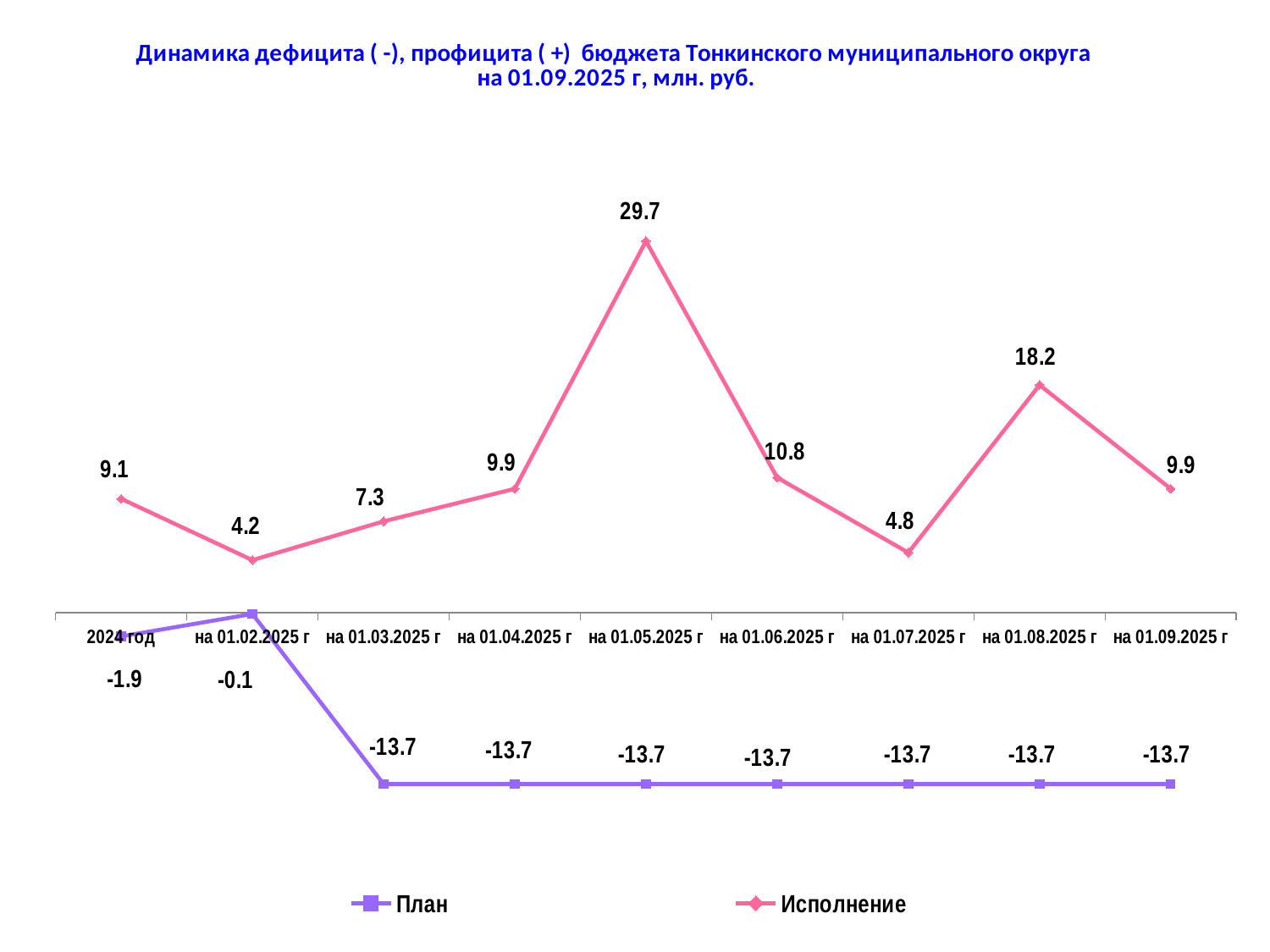
How many series does the legend list? 2 What is the value of Исполнение for на 01.05.2025 г? 29.7 Which series is drawn in pink? Исполнение What is the value of План for на 01.09.2025 г? -13.7 Which is larger: Исполнение for на 01.03.2025 г or for на 01.07.2025 г? на 01.03.2025 г For which category is Исполнение highest? на 01.05.2025 г What is the value of Исполнение for на 01.08.2025 г? 18.2 How many categories are shown on the x axis? 9 For which category is Исполнение lowest? на 01.02.2025 г What is the difference between Исполнение for на 01.05.2025 г and на 01.06.2025 г? 18.9 What is the value of План for 2024 год? -1.9 What type of chart is shown on the slide? line chart